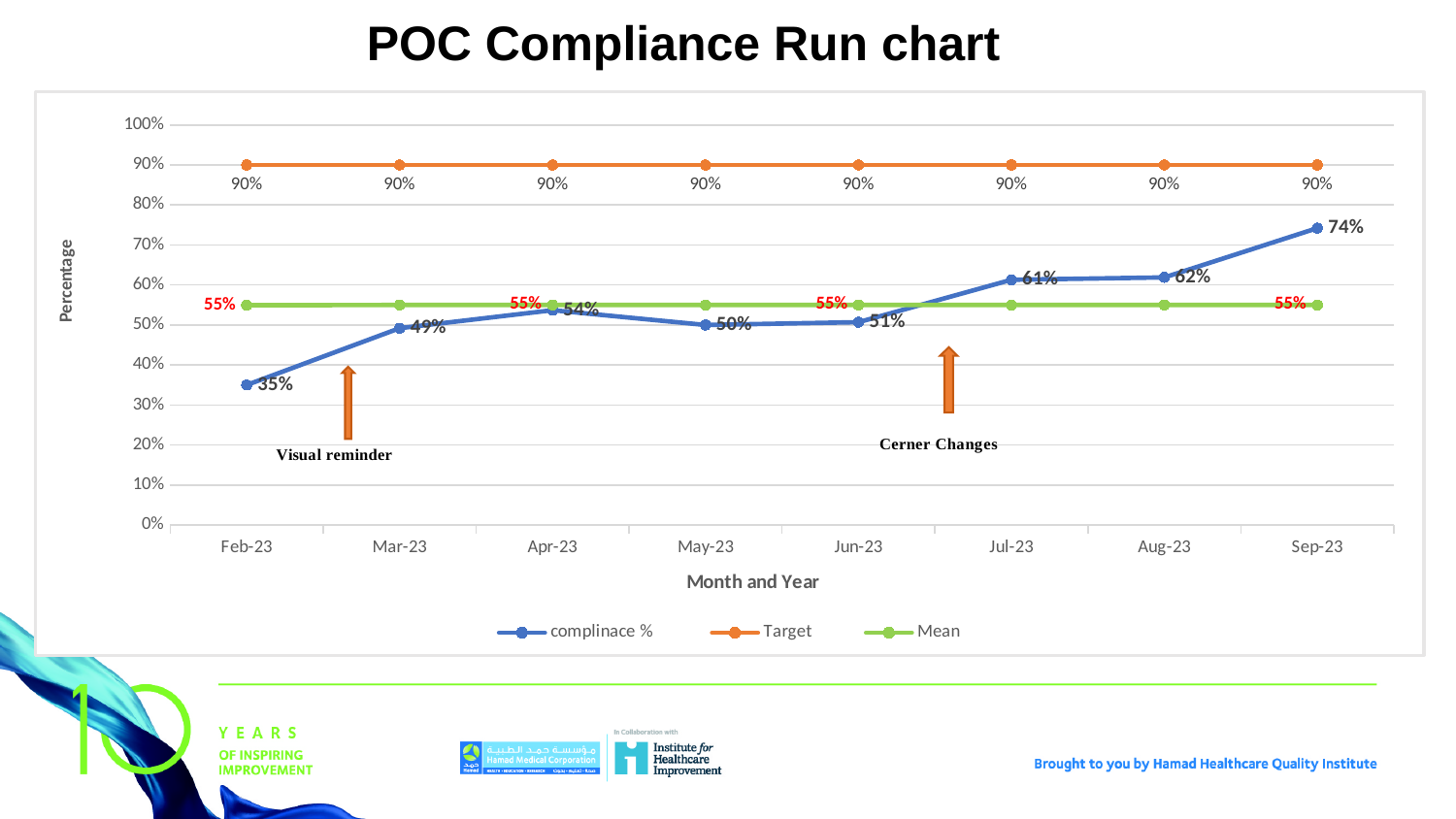
How many series does the legend list? 3 Which month has the highest compliance %? Sep-23 What is the difference between the compliance % in Sep-23 and Feb-23? 39% What kind of chart is shown on the slide? Line chart What is the compliance % value for Sep-23? 74% How many months are plotted on the x axis? 8 What is the Target value shown for each month? 90% What annotation is placed near Mar-23 on the chart? Visual reminder What is the compliance % value for Feb-23? 35% Which month has the lowest compliance %? Feb-23 What is the Mean value shown on the chart? 55% Which is larger, the compliance % in Apr-23 or in May-23? Apr-23